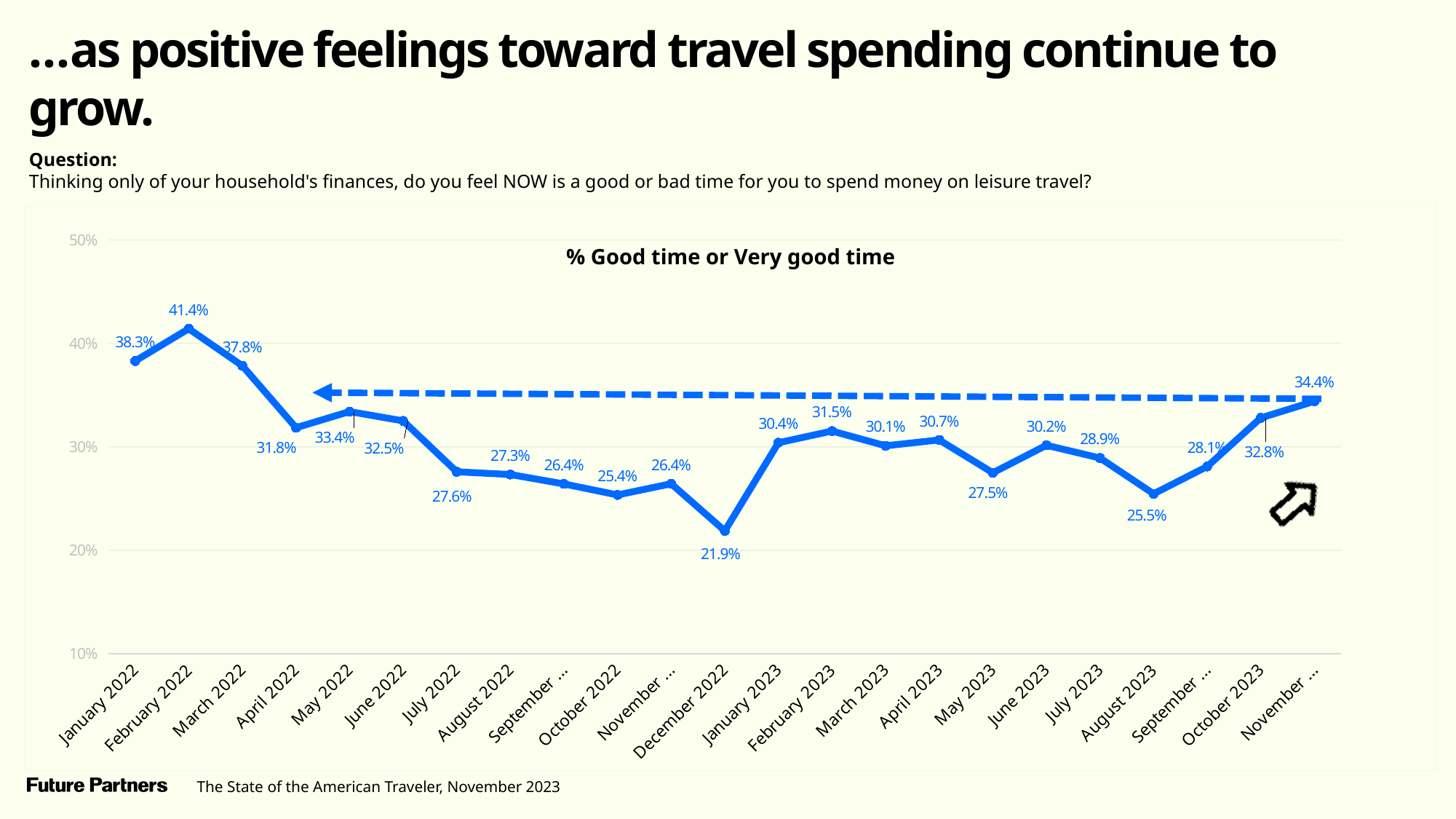
What is the difference between the values for February 2022 and January 2022? 3.1 percentage points What is the difference between the values for October 2023 and August 2023? 7.3 percentage points Which month has the highest value? February 2022 What kind of chart is shown on the slide? line chart What is the value for December 2022? 21.9% Do the values rise or fall from August 2023 to October 2023? rise How many data points are plotted on the chart? 23 What is the value for February 2022? 41.4% What is the value for October 2023? 32.8% Which is larger, the value for January 2022 or the value for March 2022? January 2022 Is the value for April 2022 greater or less than 30%? greater Which month has the lowest value? December 2022